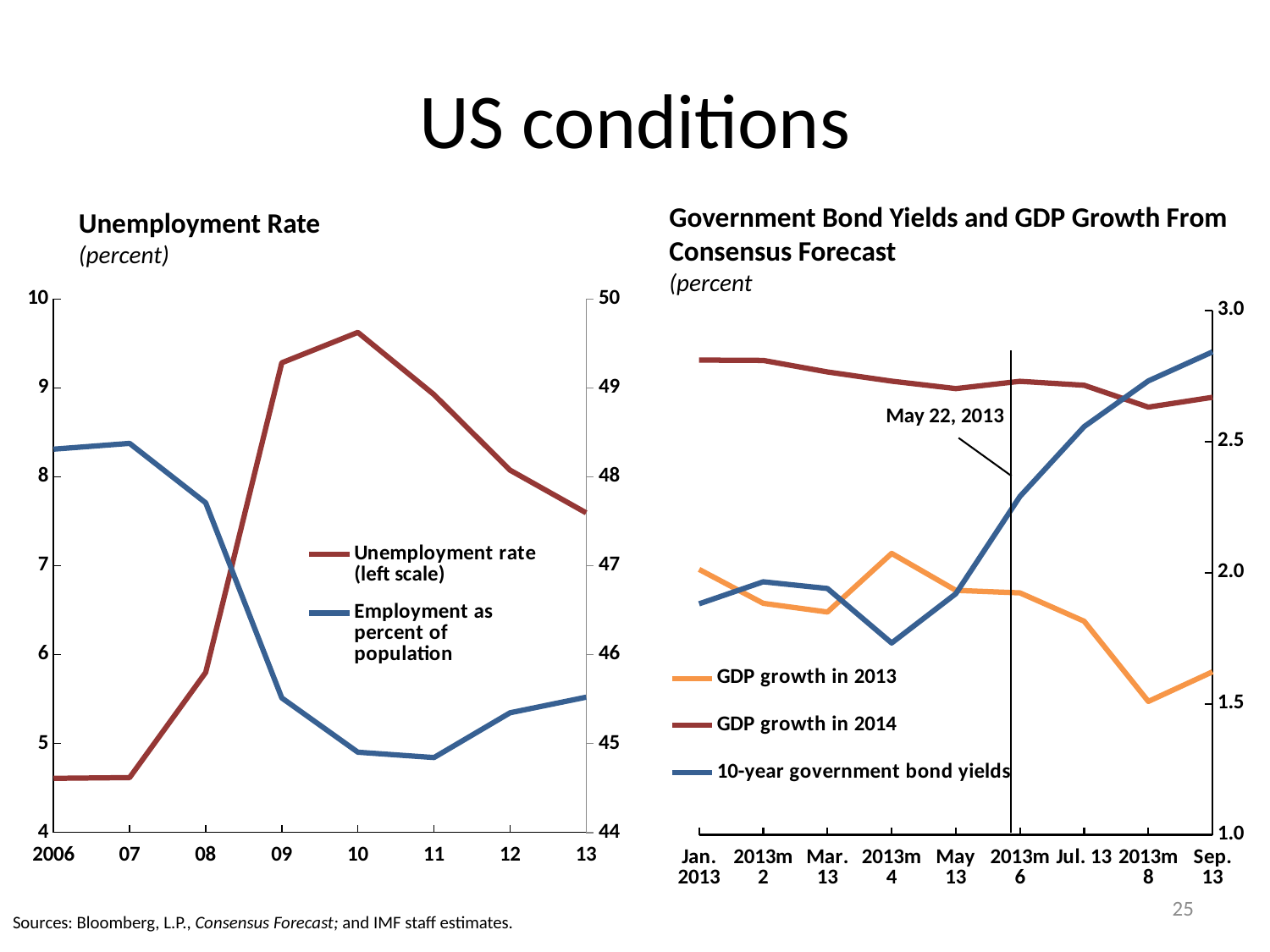
What kind of chart is the Unemployment Rate chart on the left? line chart What date is marked by the vertical line annotation in the Government Bond Yields and GDP Growth chart? May 22, 2013 In the Government Bond Yields and GDP Growth chart, at which x-axis point is GDP growth in 2013 lowest? 2013m8 In the Government Bond Yields and GDP Growth chart, is the 10-year government bond yield at 2013m4 greater or less than 2.0? less In the Government Bond Yields and GDP Growth chart, do 10-year government bond yields rise or fall from May 13 to Sep. 13? rise How many series does the legend of the Unemployment Rate chart list? 2 How many series does the legend of the Government Bond Yields and GDP Growth chart list? 3 In the Government Bond Yields and GDP Growth chart, at Sep. 13, which is larger: 10-year government bond yields or GDP growth in 2014? 10-year government bond yields In the Unemployment Rate chart, in which year does the unemployment rate reach its highest value? 10 In the Unemployment Rate chart, is the employment as percent of population in 2011 greater or less than 46? less In the Unemployment Rate chart, is the unemployment rate in 2010 greater or less than 9? greater In the Unemployment Rate chart, does the unemployment rate rise or fall from 2010 to 2013? fall